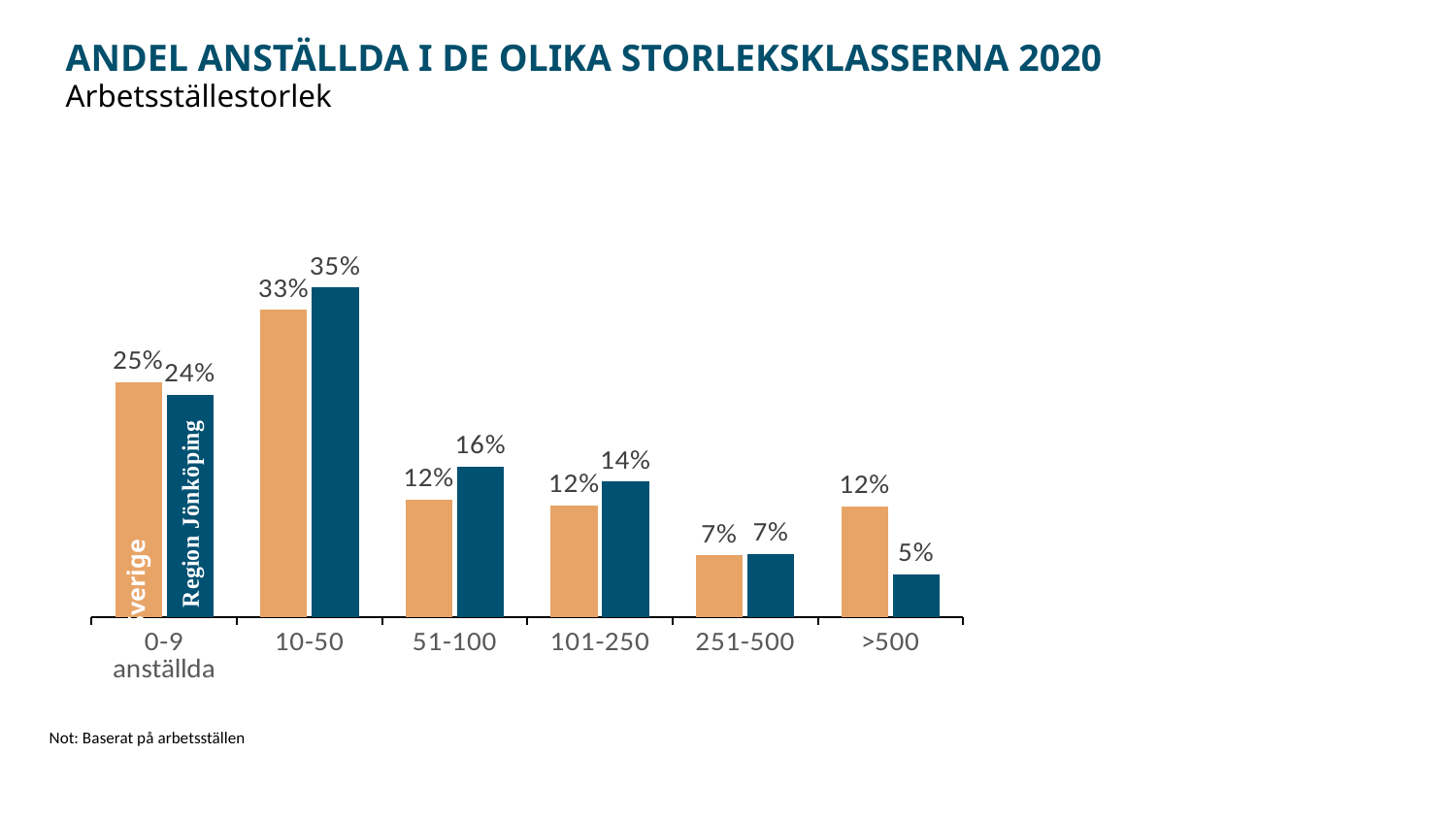
What is the difference between Sverige and Region Jönköping in the >500 category? 7% Which category has the lowest value for Sverige? 251-500 What is the difference between Region Jönköping and Sverige in the 51-100 category? 4% What is the value for Region Jönköping in the >500 category? 5% What is the value for Region Jönköping in the 51-100 category? 16% How many series does the chart show? 2 What is the value for Sverige in the 10-50 category? 33% What is the title of the chart? ANDEL ANSTÄLLDA I DE OLIKA STORLEKSKLASSERNA 2020 In the 101-250 category, which is larger, Sverige or Region Jönköping? Region Jönköping How many size categories are shown on the x axis? 6 What kind of chart is shown on the slide? Bar chart Which category has the highest value for Region Jönköping? 10-50